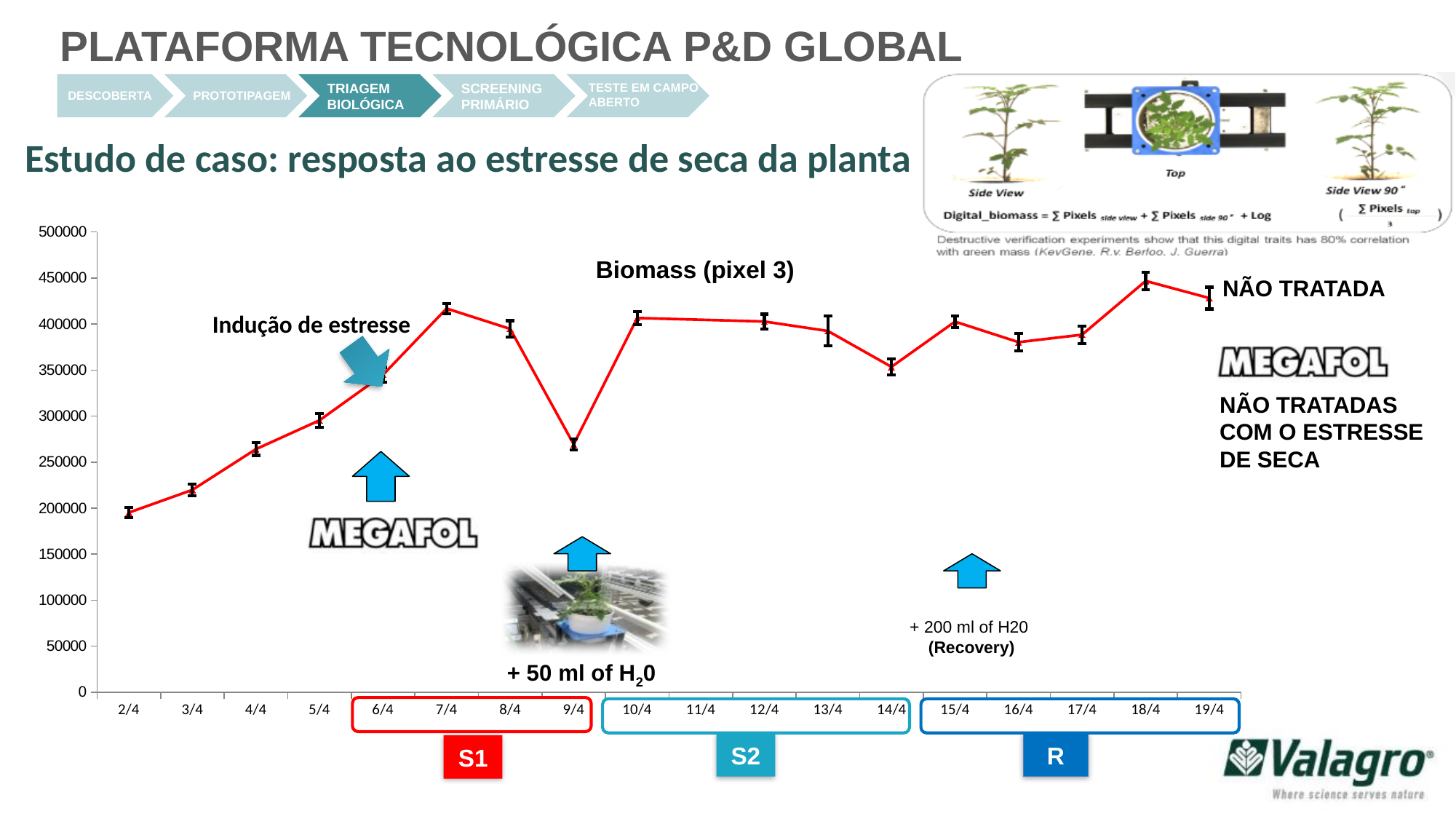
Is the biomass value for 4/4 greater or less than 250000? greater On which date is the biomass value lowest? 2/4 What type of chart is shown on the slide? line chart What is the title of the chart? Biomass (pixel 3) Which date has the larger biomass value, 7/4 or 9/4? 7/4 What is the maximum value shown on the y axis of the chart? 500000 On which date is the biomass value highest? 18/4 Does the biomass value rise or fall from 2/4 to 7/4? rise Is the biomass value for 14/4 greater or less than 400000? less Is the biomass value for 7/4 greater or less than 400000? greater How many dates are plotted along the x axis of the chart? 18